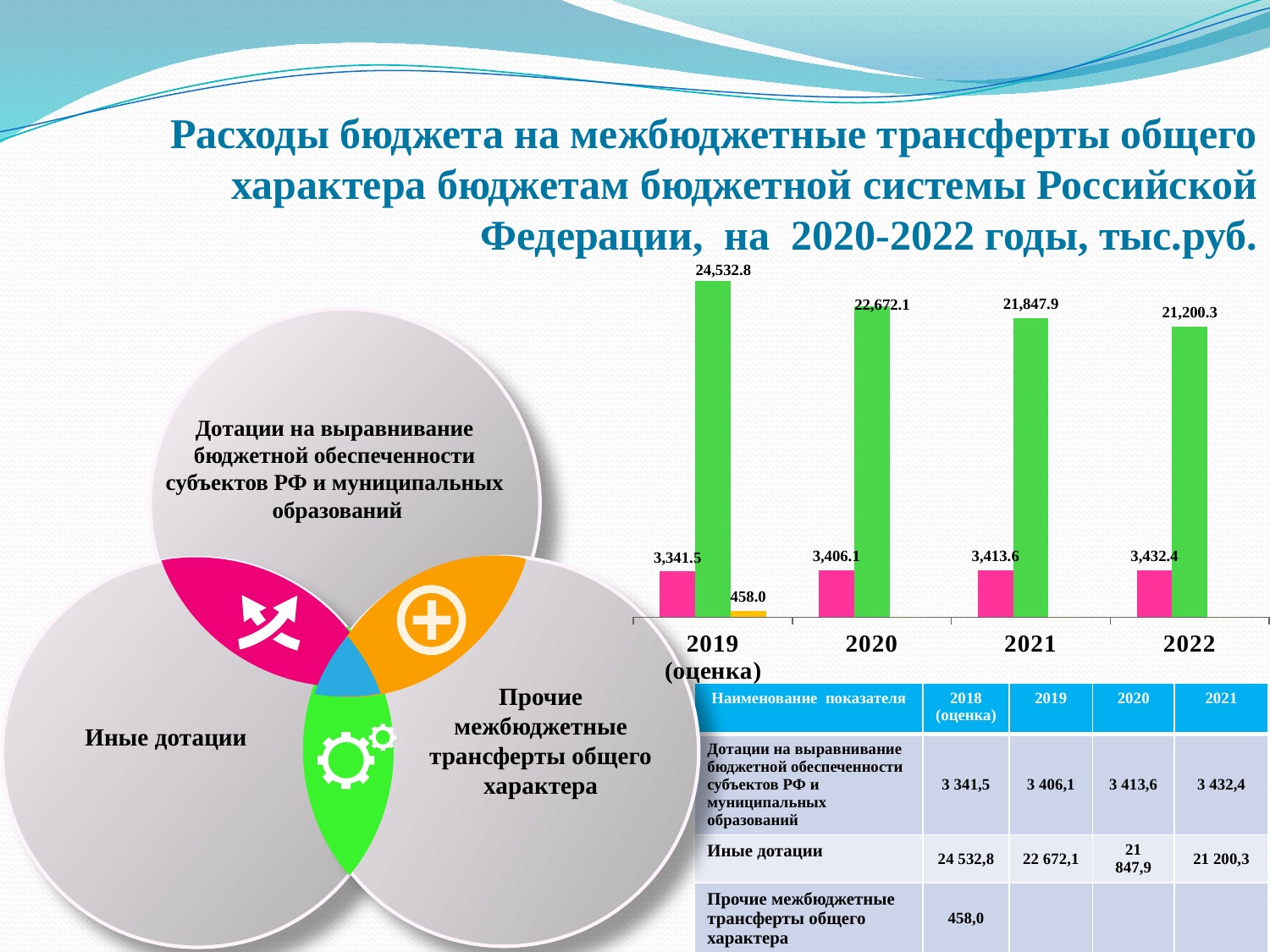
In which year is the green bar the highest? 2019 (оценка) What is the value of the green bar for 2019 (оценка)? 24,532.8 How many year categories are shown on the x axis of the chart? 4 Which is larger in 2021: the green bar or the pink bar? the green bar What is the difference between the pink bar values for 2022 and 2019 (оценка)? 90.9 What type of chart is shown on the slide? bar chart Do the green bar values rise or fall from 2019 (оценка) to 2022? fall What is the value of the pink bar for 2022? 3,432.4 What is the value of the orange bar for 2019 (оценка)? 458.0 What is the difference between the green bar values for 2019 (оценка) and 2022? 3,332.5 What is the value of the green bar for 2020? 22,672.1 In which year is the green bar the lowest? 2022